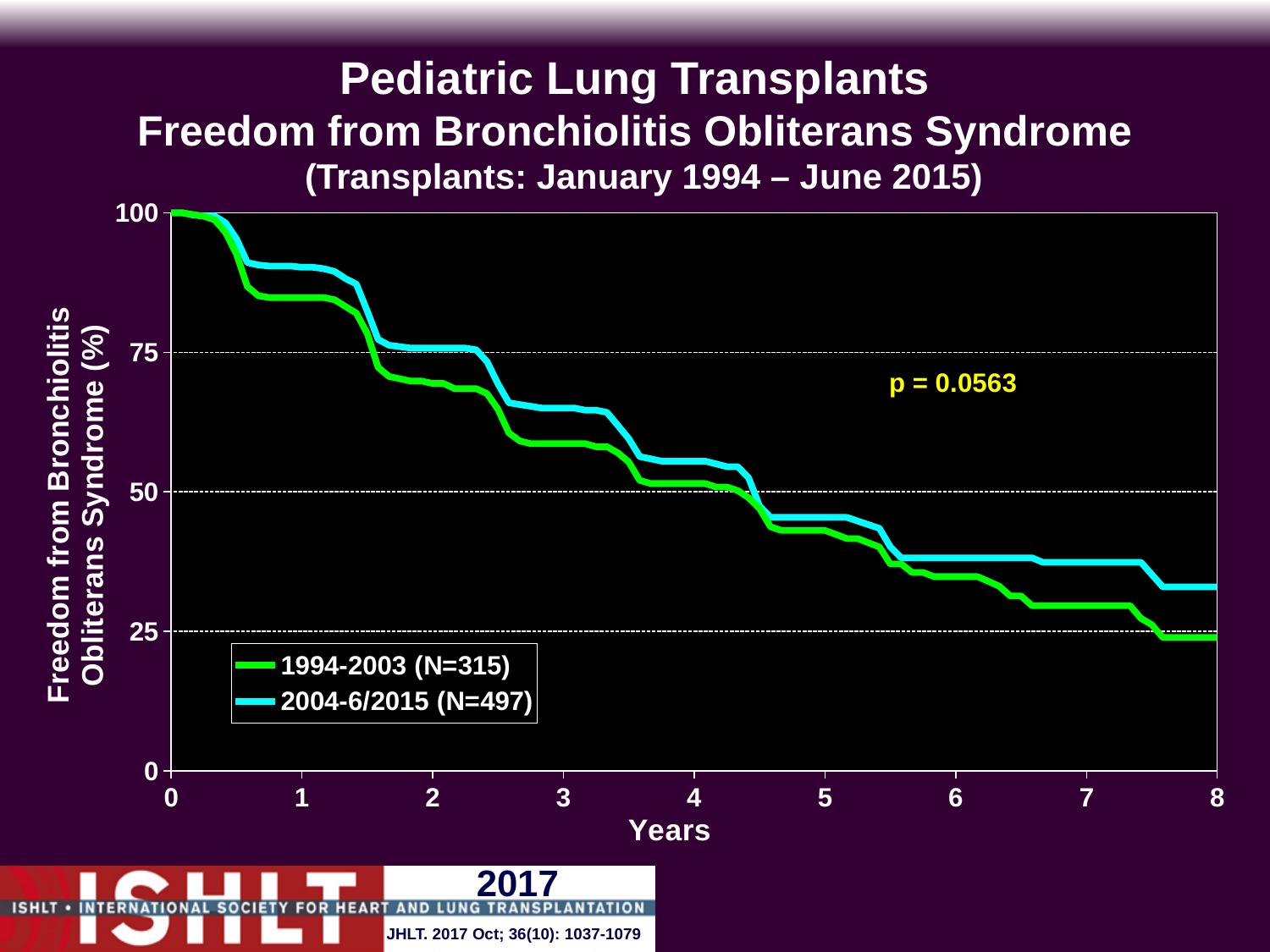
Is the value for the 2004-6/2015 series at 4 years greater or less than 50? greater Is the value for the 2004-6/2015 series at 8 years greater or less than 25? greater What is the N for the 2004-6/2015 series in the legend? N=497 Do the values for the 1994-2003 series rise or fall as years increase? fall Is the value for the 1994-2003 series at 6 years greater or less than 50? less At 7 years, which series has the higher freedom from bronchiolitis obliterans syndrome, 1994-2003 or 2004-6/2015? 2004-6/2015 What is the p-value shown on the chart? p = 0.0563 What is the label of the x axis? Years What kind of chart is shown on the slide? line chart How many series does the legend list? 2